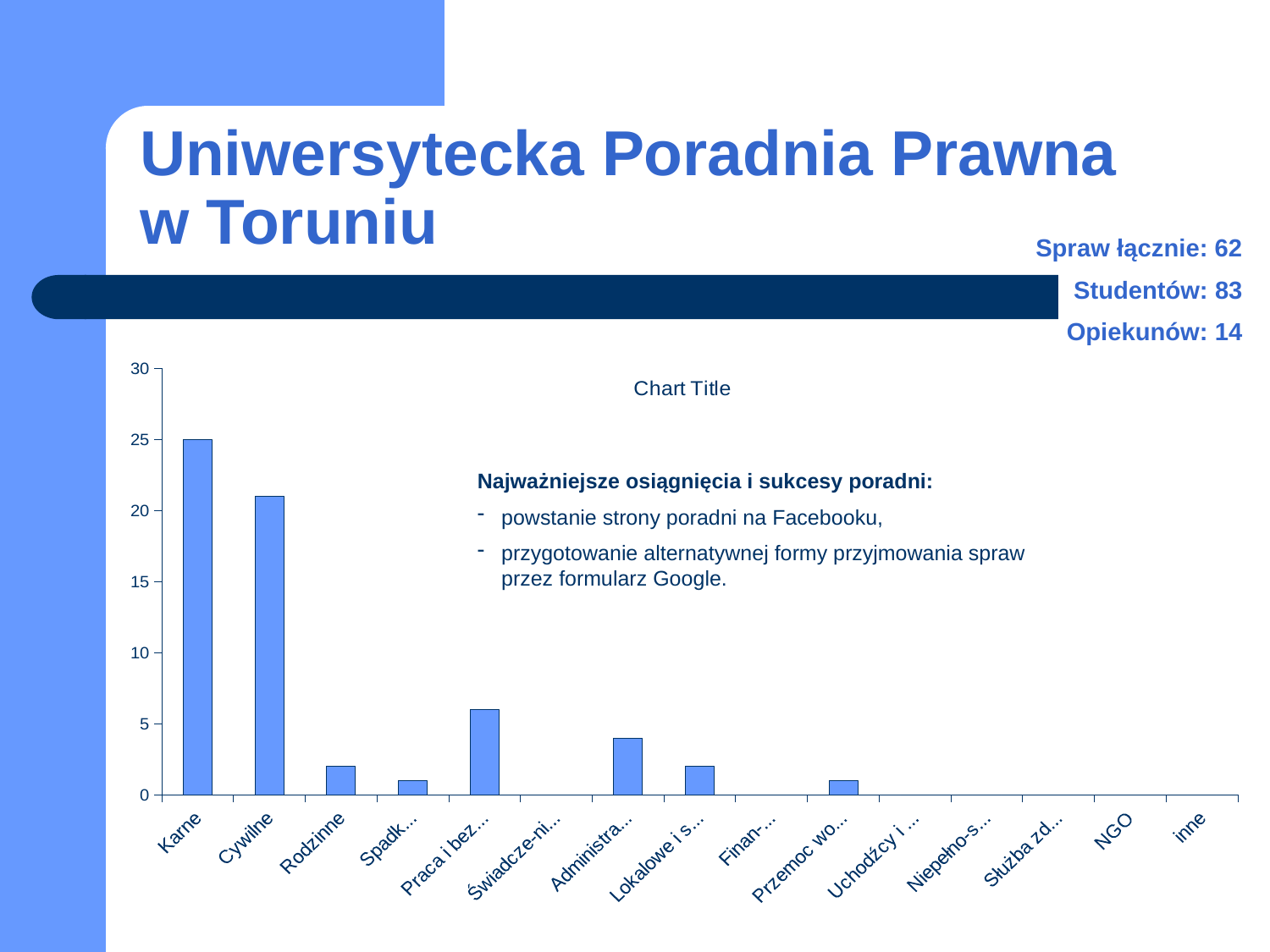
Is the value for Administra... greater or less than 5? less Is the value for Cywilne greater or less than 20? greater What kind of chart is shown on the slide? bar chart Which is larger, the value for Praca i bez... or the value for Administra...? Praca i bez... How many categories are shown on the x axis of the chart? 15 Which is larger, the value for Rodzinne or the value for Praca i bez...? Praca i bez... Is the value for Praca i bez... greater or less than 5? greater Which is larger, the value for Karne or the value for Cywilne? Karne What is the title shown on the chart? Chart Title Which category has the highest value in the chart? Karne What is the value for Karne? 25